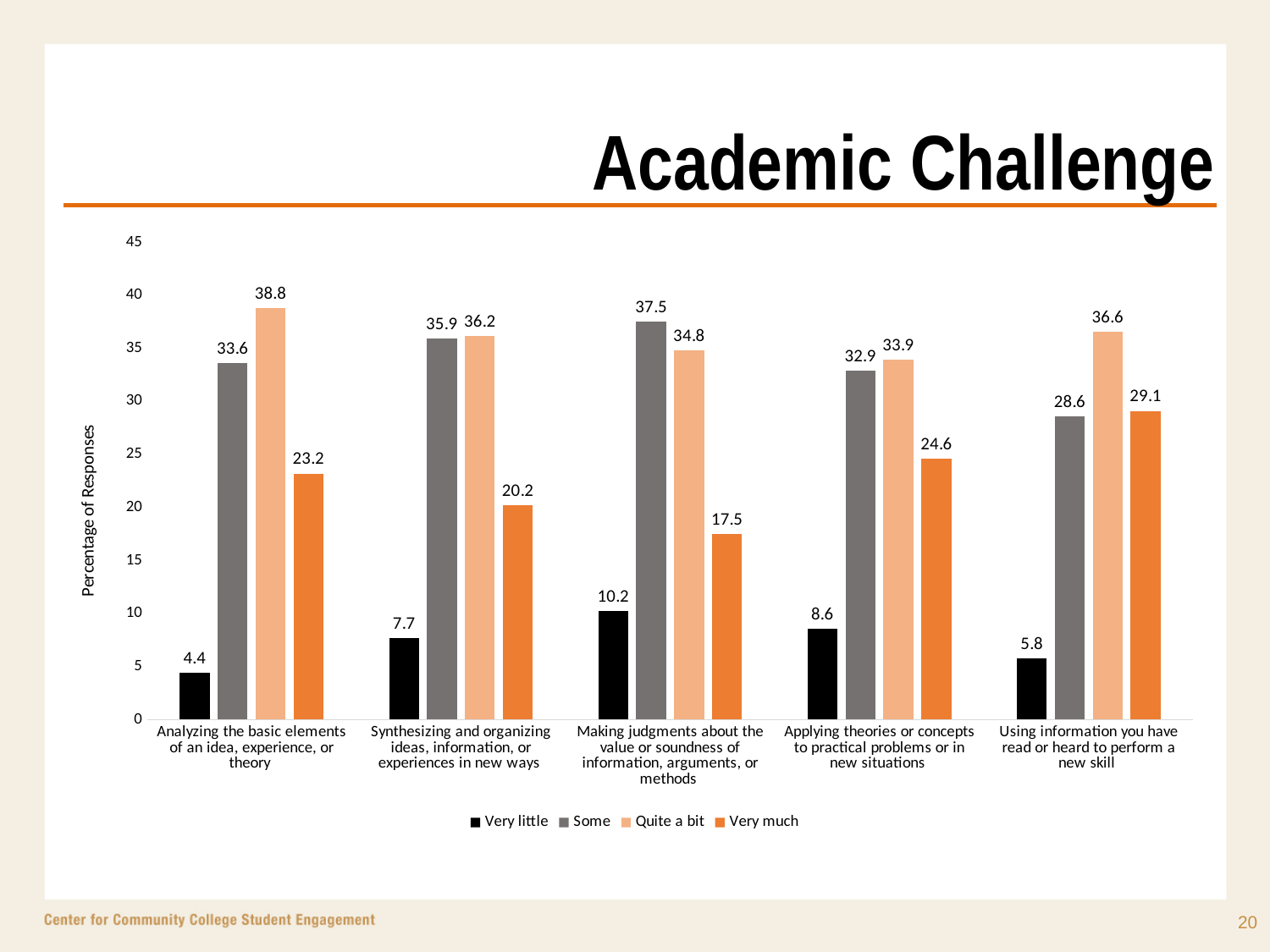
What is the label of the y axis? Percentage of Responses How many series does the legend list? 4 Is the "Very much" value for "Using information you have read or heard to perform a new skill" greater or less than 25? greater What is the difference between the "Quite a bit" and "Very much" values in the "Synthesizing and organizing ideas, information, or experiences in new ways" category? 16.0 What is the value for "Quite a bit" in the "Using information you have read or heard to perform a new skill" category? 36.6 Which category has the lowest "Very much" value? Making judgments about the value or soundness of information, arguments, or methods Which category has the highest "Very little" value? Making judgments about the value or soundness of information, arguments, or methods How many categories are shown on the x axis? 5 What kind of chart is shown on the slide? bar chart What is the value for "Very little" in the "Analyzing the basic elements of an idea, experience, or theory" category? 4.4 What is the value for "Very much" in the "Making judgments about the value or soundness of information, arguments, or methods" category? 17.5 Which is larger in the "Applying theories or concepts to practical problems or in new situations" category: "Some" or "Quite a bit"? Quite a bit